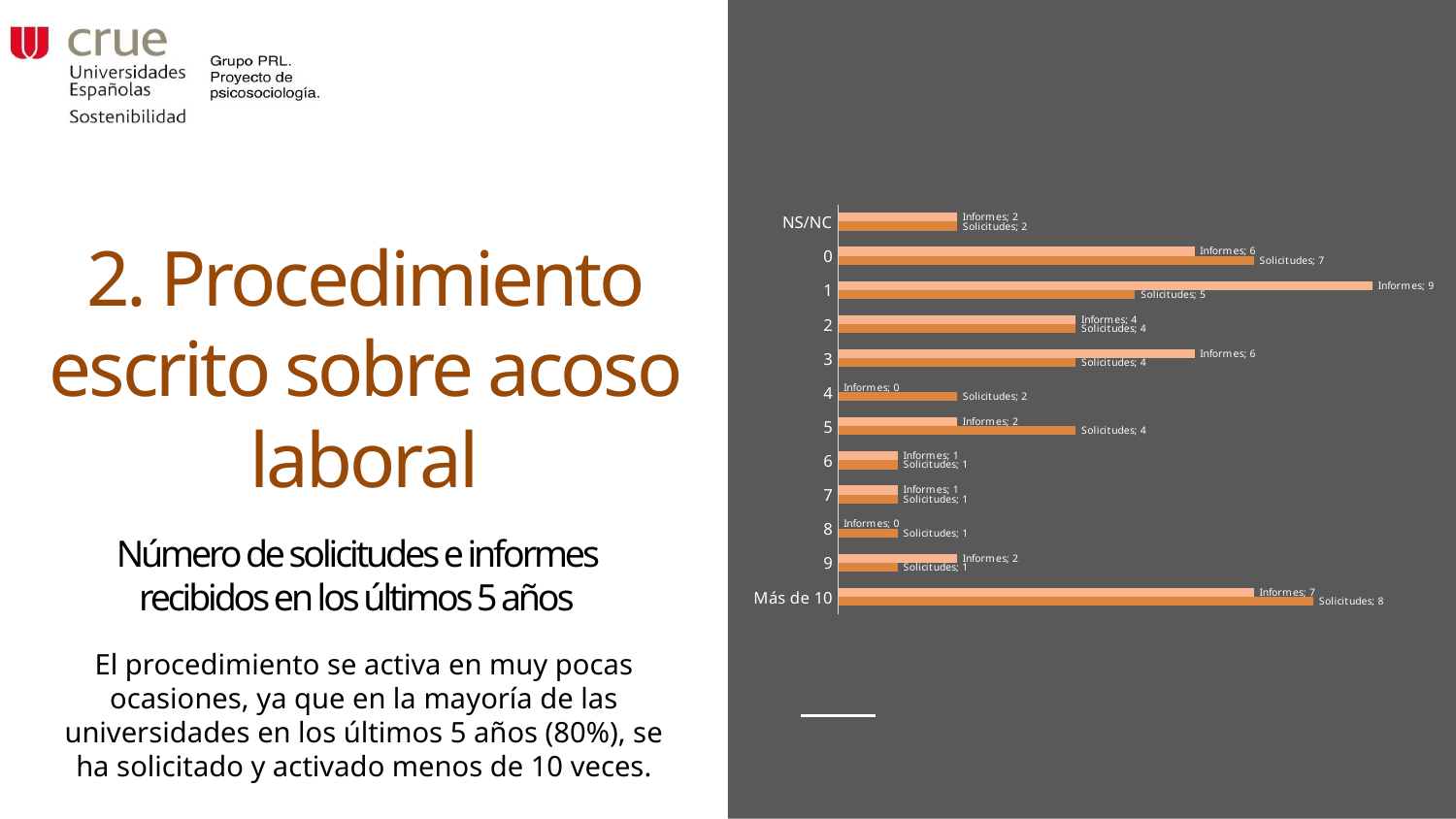
What is the difference between Solicitudes and Informes for category 5? 2 For category 3, which is larger, Informes or Solicitudes? Informes Which category has the highest value for Solicitudes? Más de 10 What is the value of Informes for category 1? 9 What is the value of Informes for category 4? 0 What is the value of Solicitudes for the category Más de 10? 8 How many categories are shown on the chart? 12 What is the difference between Informes and Solicitudes for category 1? 4 For category 0, which is larger, Informes or Solicitudes? Solicitudes What is the value of Solicitudes for category 0? 7 Which category has the highest value for Informes? 1 What kind of chart is shown on the slide? Bar chart